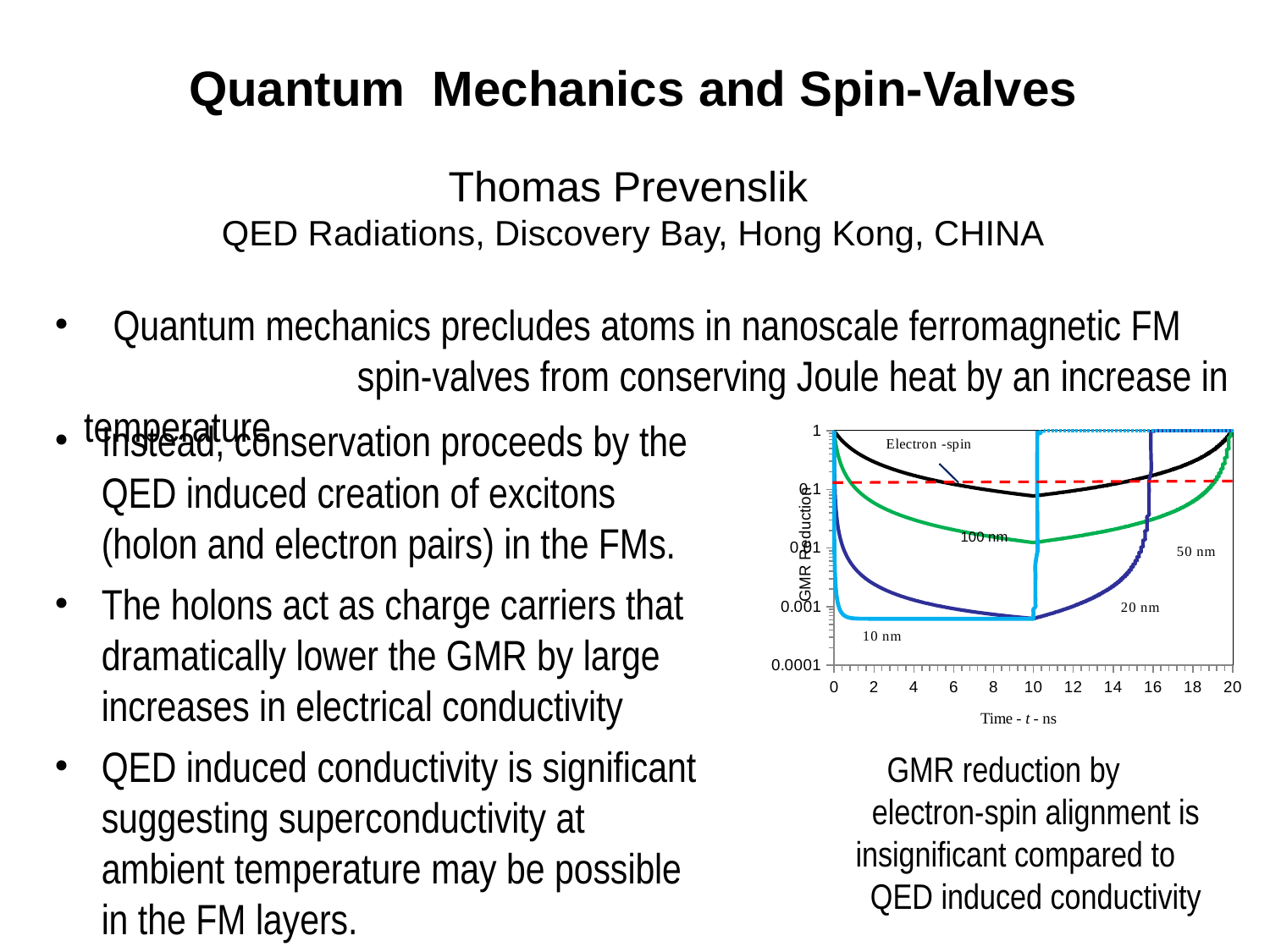
Does the Electron-spin curve rise or fall between time 0 and time 10? fall What is the highest value shown on the y axis of the chart? 1 What is the label of the y axis of the chart? GMR Reduction Is the value of the 10 nm curve at time 5 greater or less than 0.01? less What is the maximum time shown on the x axis of the chart? 20 Is the value of the 100 nm curve at time 10 greater or less than 0.1? less How many film-thickness labels in nm are shown on the chart? 4 What is the label of the x axis of the chart? Time - t - ns What kind of chart is shown on the slide? line chart Which labeled curve reaches the lowest GMR Reduction value on the chart? 10 nm What is the lowest value shown on the y axis of the chart? 0.0001 Which labeled curve stays highest on the chart across the whole time range? Electron -spin